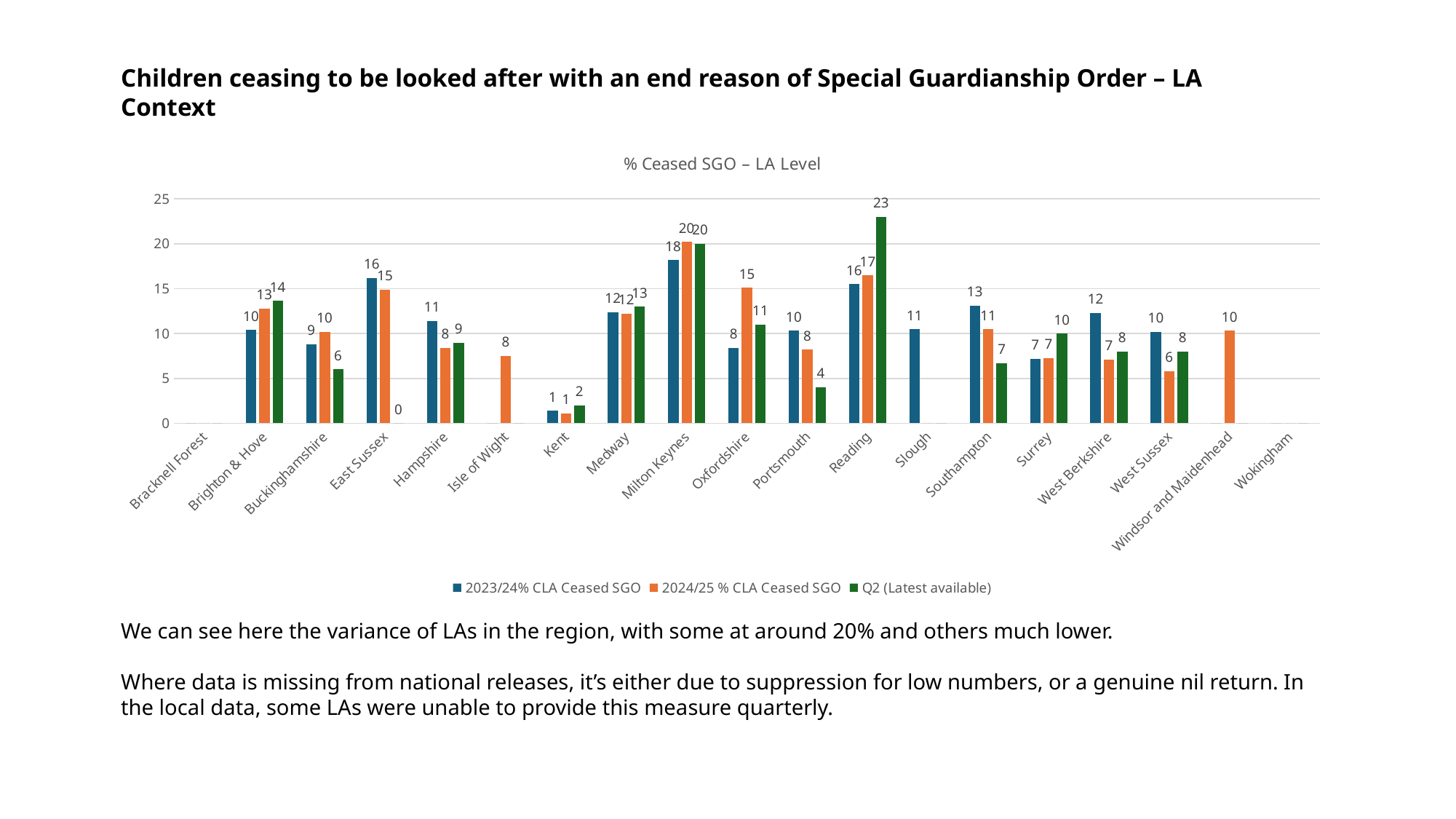
Which is larger: the 2024/25 % CLA Ceased SGO value for Southampton or the 2024/25 % CLA Ceased SGO value for Brighton & Hove? Brighton & Hove Which local authority has the highest Q2 (Latest available) value? Reading What kind of chart is shown on the slide? Bar chart What is the difference between the Q2 (Latest available) value for Reading and the Q2 (Latest available) value for Portsmouth? 19 How many series does the legend list? 3 Which local authority has the lowest 2023/24% CLA Ceased SGO value among those with a bar shown? Kent How many local authorities are listed on the x axis? 19 Is the 2024/25 % CLA Ceased SGO value for Milton Keynes greater or less than 15? greater What is the title of the chart? % Ceased SGO – LA Level What is the Q2 (Latest available) value for Reading? 23 What is the 2023/24% CLA Ceased SGO value for Milton Keynes? 18 What is the 2024/25 % CLA Ceased SGO value for Oxfordshire? 15